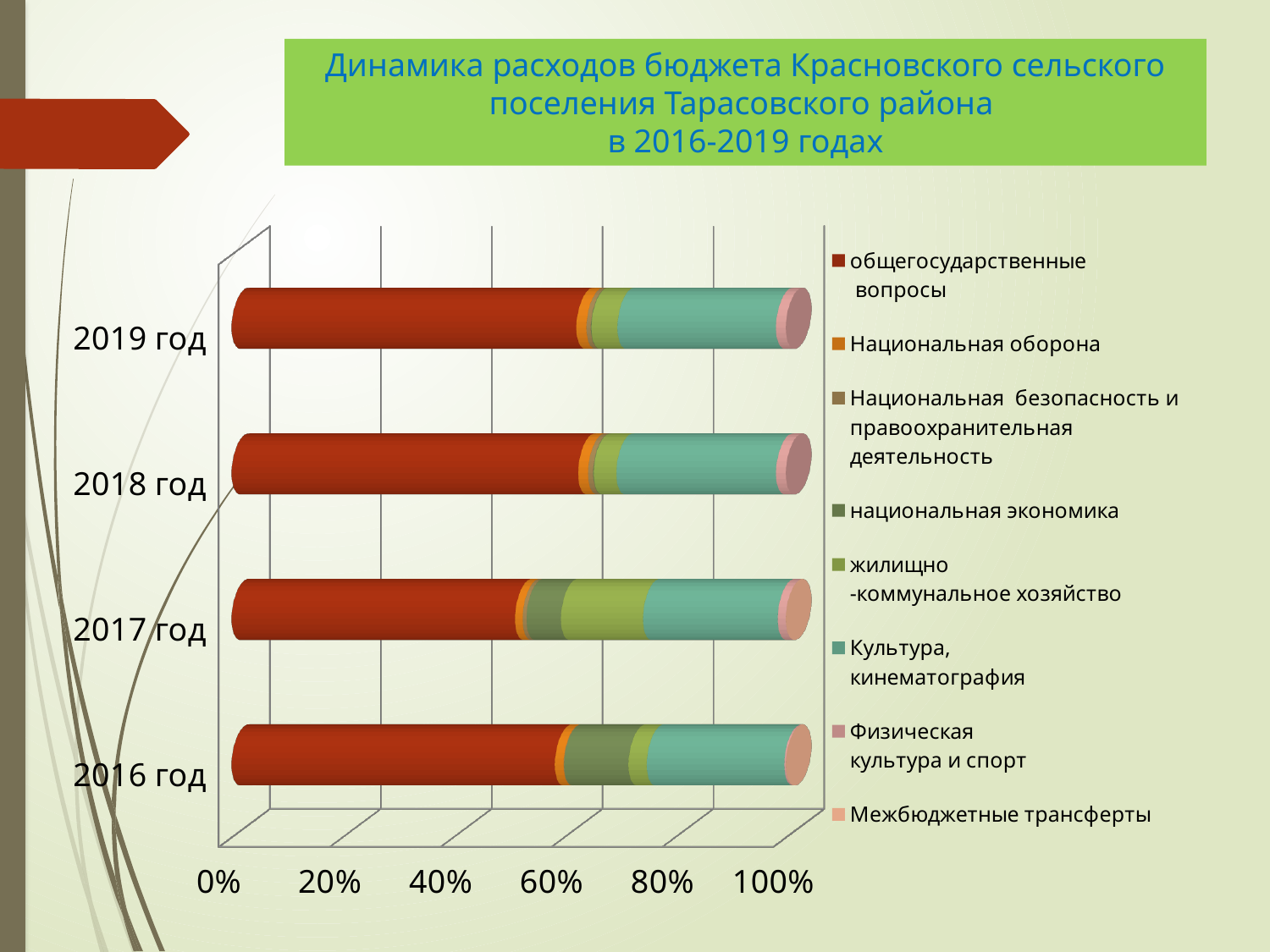
What is the title of the chart? Динамика расходов бюджета Красновского сельского поселения Тарасовского района в 2016-2019 годах Is the share of общегосударственные вопросы in 2017 год greater or less than 60%? less Which legend entry is shown in dark red? общегосударственные вопросы What kind of chart is shown on the slide? stacked bar chart Which year has the larger share for жилищно-коммунальное хозяйство, 2017 год or 2019 год? 2017 год Is the share of общегосударственные вопросы in 2019 год greater or less than 40%? greater Is the share of общегосударственные вопросы in 2018 год greater or less than 80%? less Which year has the larger share for общегосударственные вопросы, 2018 год or 2017 год? 2018 год How many years (categories) are shown on the chart? 4 How many series does the legend list? 8 Which year has the smallest share for общегосударственные вопросы? 2017 год What does each stacked bar total according to the axis? 100%